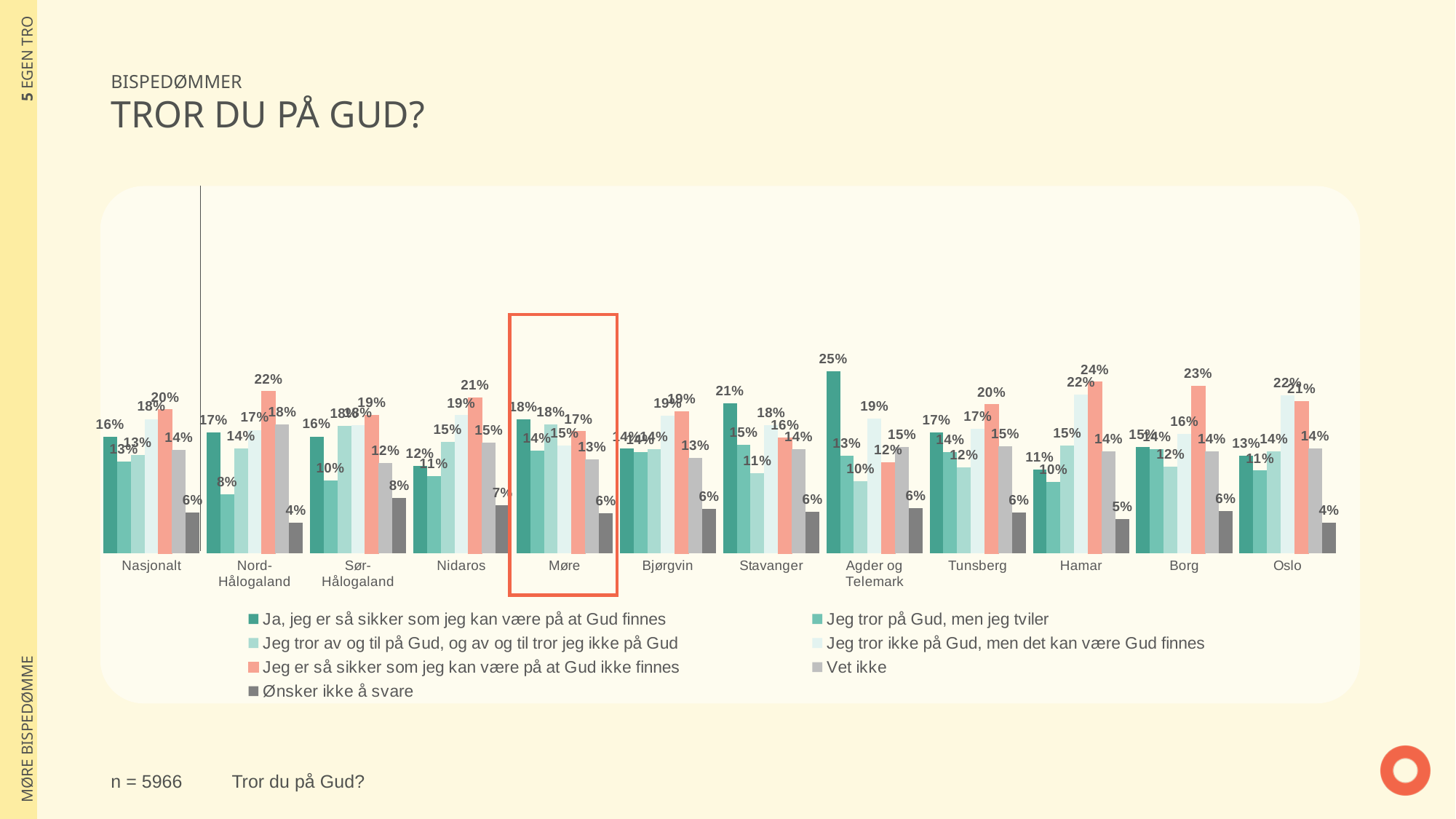
Which category has the lowest value for 'Jeg tror på Gud, men jeg tviler'? Nord-Hålogaland Which is larger in Stavanger: 'Ja, jeg er så sikker som jeg kan være på at Gud finnes' or 'Jeg er så sikker som jeg kan være på at Gud ikke finnes'? Ja, jeg er så sikker som jeg kan være på at Gud finnes What is the value for 'Jeg er så sikker som jeg kan være på at Gud ikke finnes' in Hamar? 24% Which category has the highest value for 'Ja, jeg er så sikker som jeg kan være på at Gud finnes'? Agder og Telemark How many series does the legend list? 7 What is the value for 'Vet ikke' in Nord-Hålogaland? 18% What is the value for 'Ja, jeg er så sikker som jeg kan være på at Gud finnes' in Agder og Telemark? 25% Which category is highlighted with an orange rectangle on the chart? Møre How many bispedømme categories (including Nasjonalt) are shown on the x axis? 12 What is the difference between the 'Jeg er så sikker som jeg kan være på at Gud ikke finnes' values for Borg and Agder og Telemark? 11% What kind of chart is shown on the slide? bar chart What is the sample size (n) stated on the slide? 5966